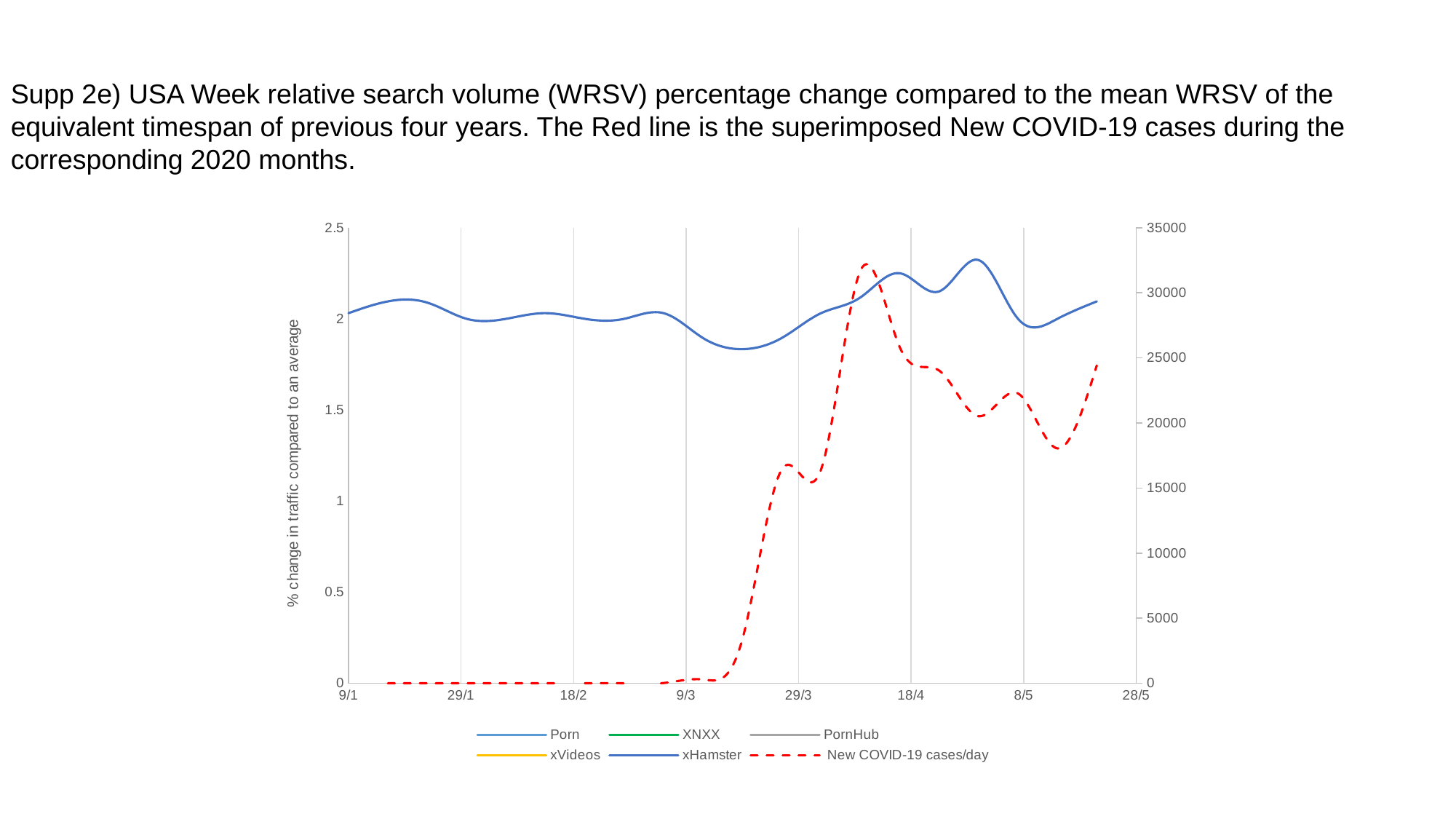
Do the New COVID-19 cases/day values rise or fall between 9/3 and 29/3? rise Is the xHamster value at 9/3 greater or less than 1.5? greater Which series is drawn as a red dashed line? New COVID-19 cases/day Is the xHamster value at 9/1 greater or less than 1.5? greater Is the New COVID-19 cases/day value at 9/3 greater or less than 5000? less What kind of chart is shown on the slide? Line chart Do the New COVID-19 cases/day values rise or fall between 18/4 and 8/5? fall How many date labels are shown on the x axis? 8 What is the label of the left vertical axis? % change in traffic compared to an average How many series does the legend list? 6